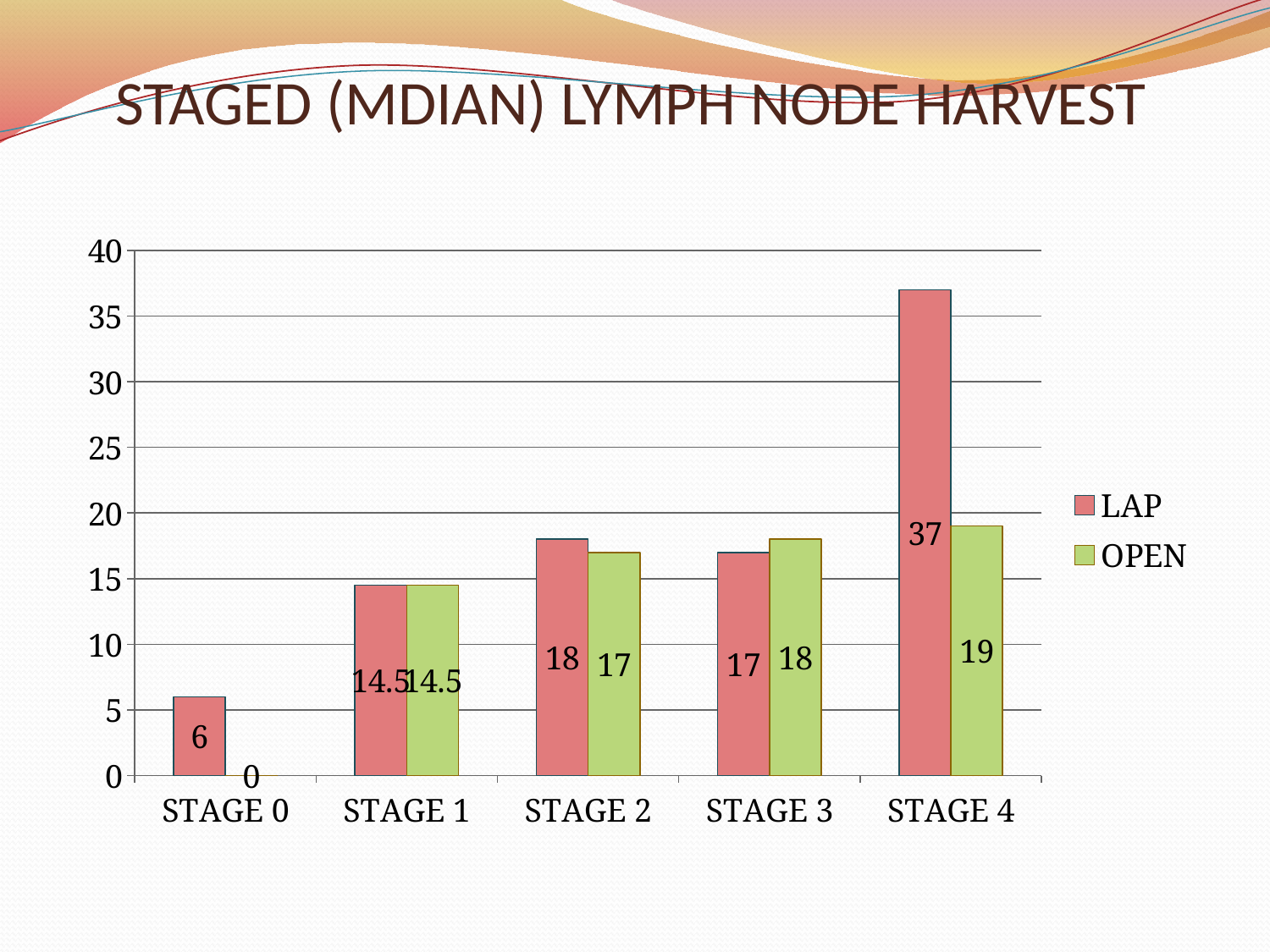
What is the difference between the LAP and OPEN values for STAGE 4? 18 What is the LAP value for STAGE 4? 37 How many series does the legend list? 2 What kind of chart is shown on the slide? Bar chart How many stages are shown on the x axis? 5 For STAGE 3, which is larger, LAP or OPEN? OPEN Which stage has the lowest OPEN value? STAGE 0 What is the title of the slide? STAGED (MDIAN) LYMPH NODE HARVEST What is the LAP value for STAGE 0? 6 What is the OPEN value for STAGE 2? 17 Which stage has the highest LAP value? STAGE 4 What is the OPEN value for STAGE 1? 14.5